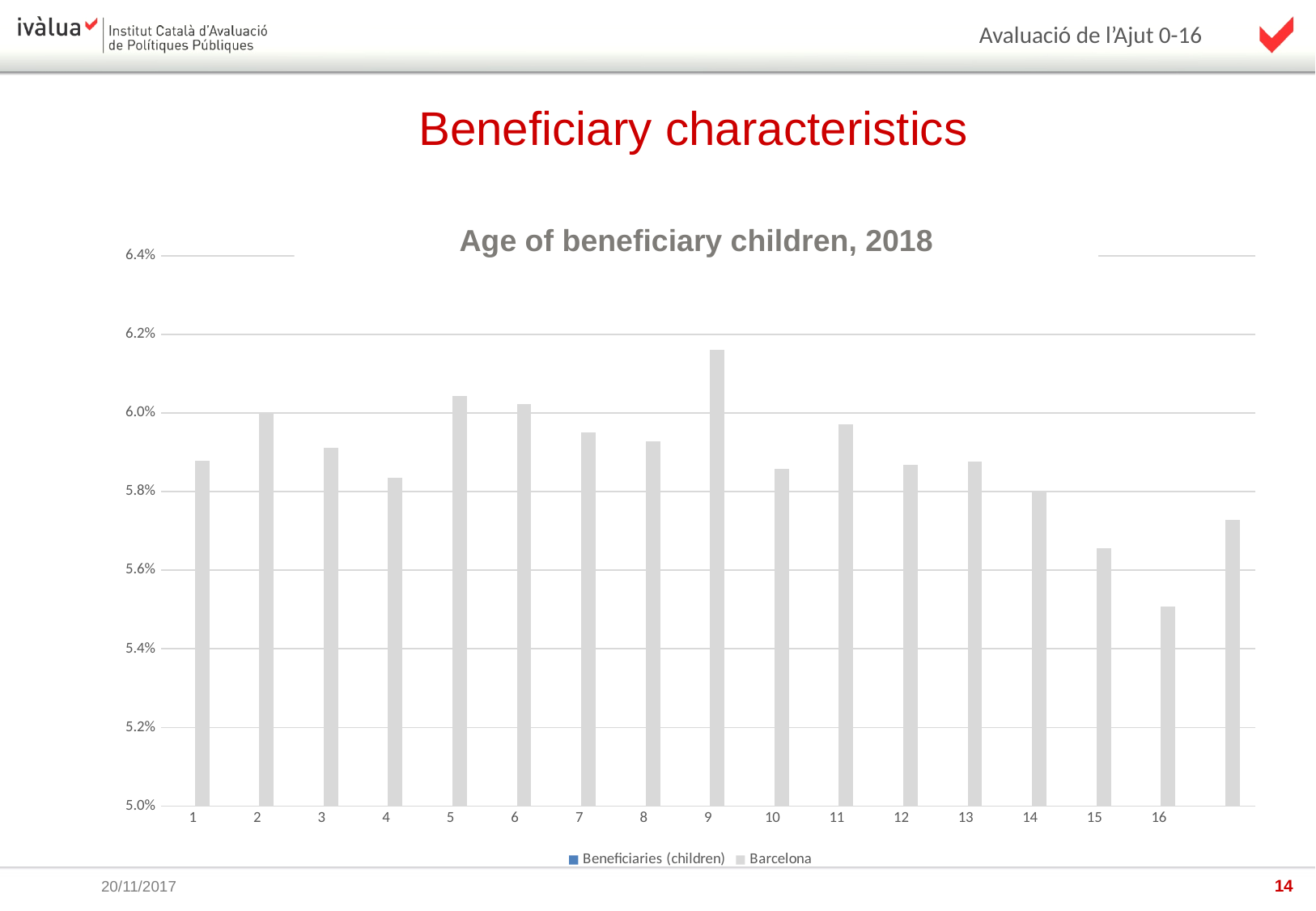
Is the Barcelona value for age 5 greater or less than 6.0%? greater What is the title of the chart? Age of beneficiary children, 2018 Which has the larger Barcelona value, age 5 or age 4? 5 Which age category has the highest Barcelona value? 9 How many series does the legend list? 2 Is the Barcelona value for age 9 greater or less than 6.0%? greater Do the Barcelona values rise or fall from age 13 to age 16? fall Is the Barcelona value for age 16 greater or less than 5.6%? less What kind of chart is shown on the slide? bar chart Which has the larger Barcelona value, age 15 or age 16? 15 Which labelled age category has the lowest Barcelona value? 16